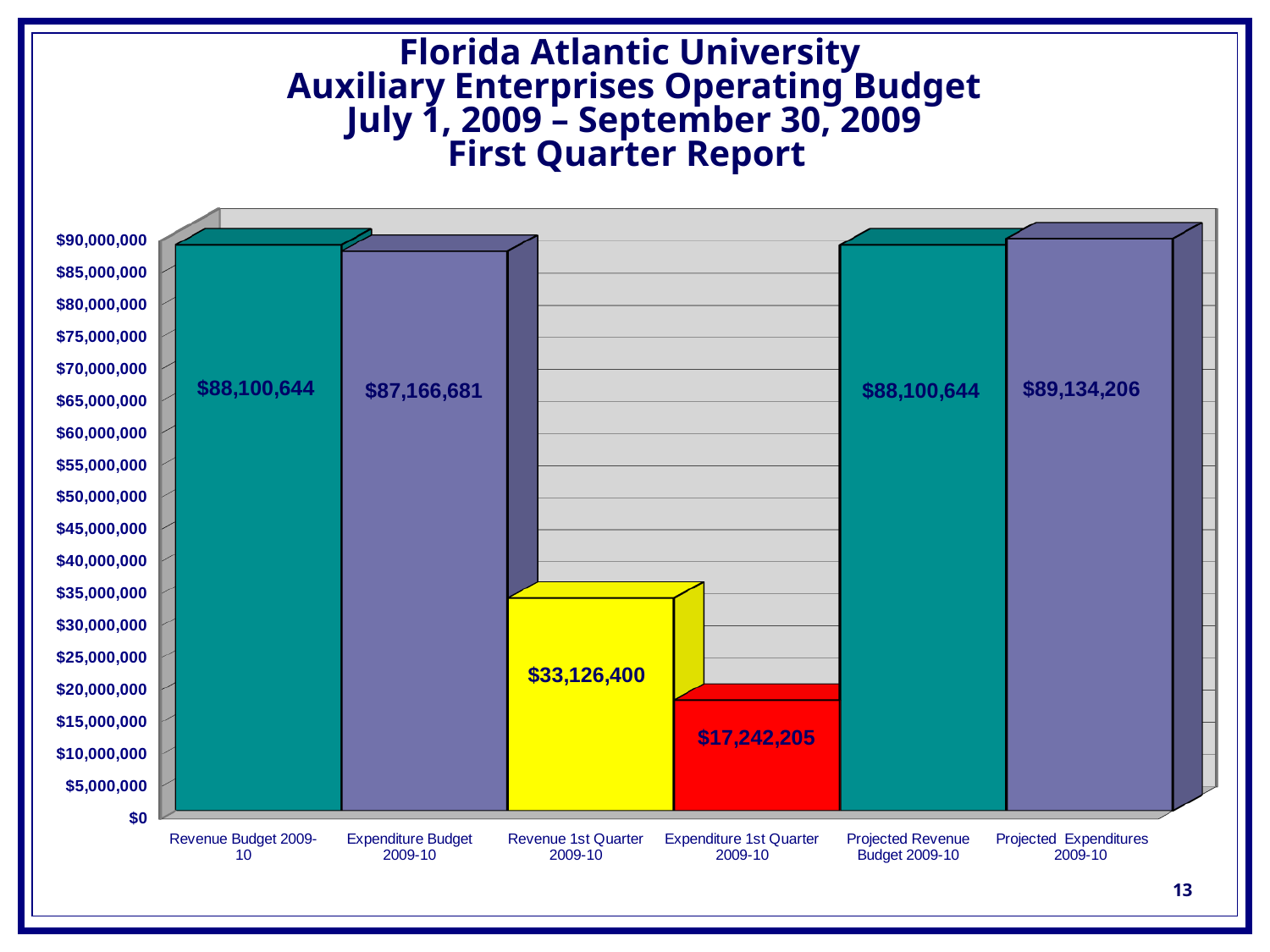
Which is larger, Revenue 1st Quarter 2009-10 or Expenditure 1st Quarter 2009-10? Revenue 1st Quarter 2009-10 What is the value for Expenditure Budget 2009-10? $87,166,681 What is the difference between Revenue 1st Quarter 2009-10 and Expenditure 1st Quarter 2009-10? $15,884,195 What is the value for Expenditure 1st Quarter 2009-10? $17,242,205 What is the value for Projected Expenditures 2009-10? $89,134,206 Which category has the highest value? Projected Expenditures 2009-10 What is the value for Revenue 1st Quarter 2009-10? $33,126,400 What is the value for Revenue Budget 2009-10? $88,100,644 What kind of chart is shown on the slide? Bar chart How many categories are shown on the chart? 6 Which category has the lowest value? Expenditure 1st Quarter 2009-10 What is the difference between Projected Expenditures 2009-10 and Projected Revenue Budget 2009-10? $1,033,562